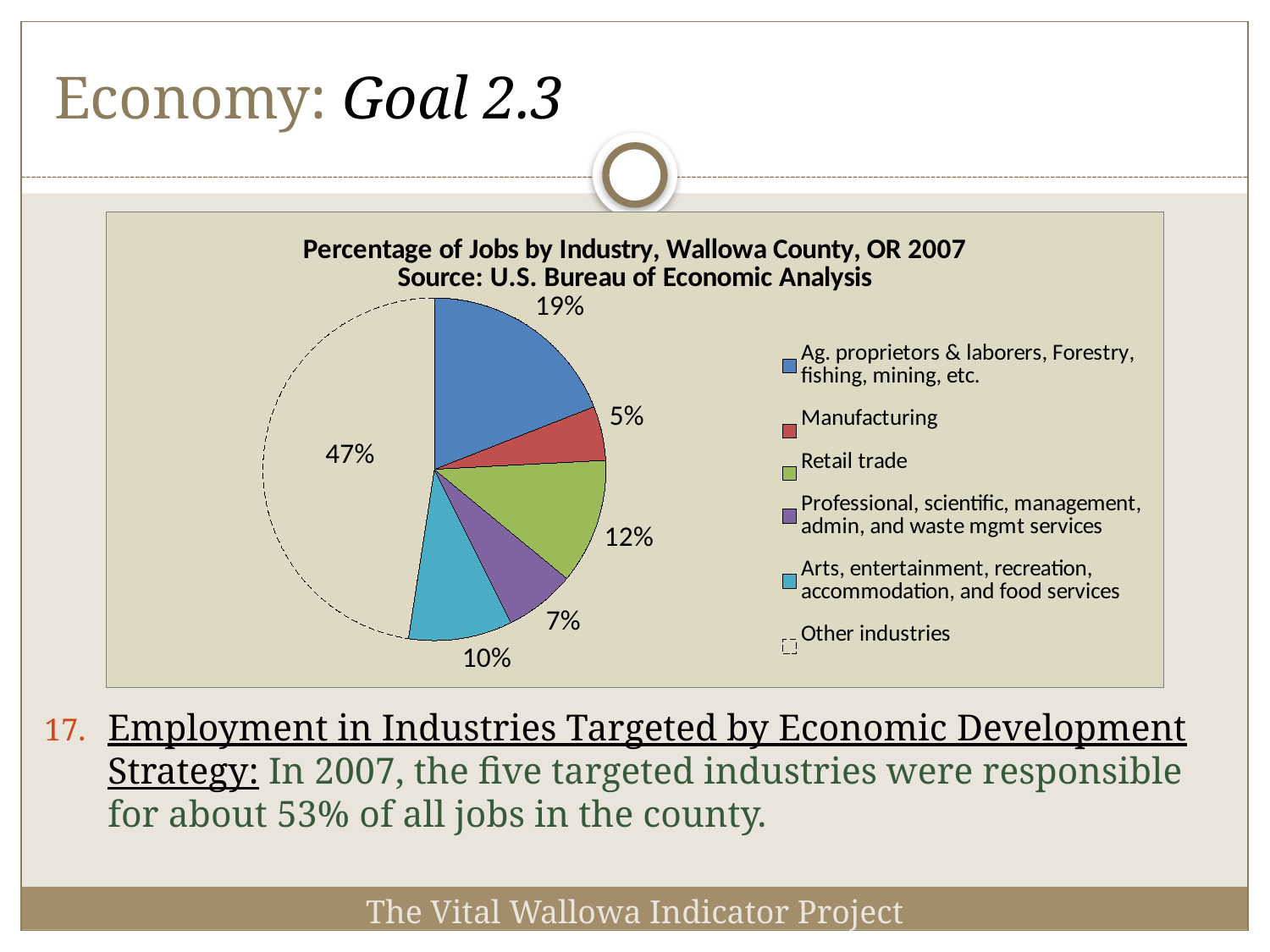
What kind of chart is shown on the slide? pie chart Which category has the largest share of the pie? Other industries What percentage of jobs is shown for Manufacturing? 5% What is the difference in percentage points between Retail trade and Manufacturing? 7 What is the title of the chart? Percentage of Jobs by Industry, Wallowa County, OR 2007 How many categories does the legend list? 6 What source is cited in the chart title? U.S. Bureau of Economic Analysis What percentage of jobs is shown for Retail trade? 12% What percentage of jobs is shown for Other industries? 47% What percentage of jobs is shown for Ag. proprietors & laborers, Forestry, fishing, mining, etc.? 19% Which has a larger share of jobs: Arts, entertainment, recreation, accommodation, and food services or Professional, scientific, management, admin, and waste mgmt services? Arts, entertainment, recreation, accommodation, and food services Which industry category has the smallest share of jobs? Manufacturing